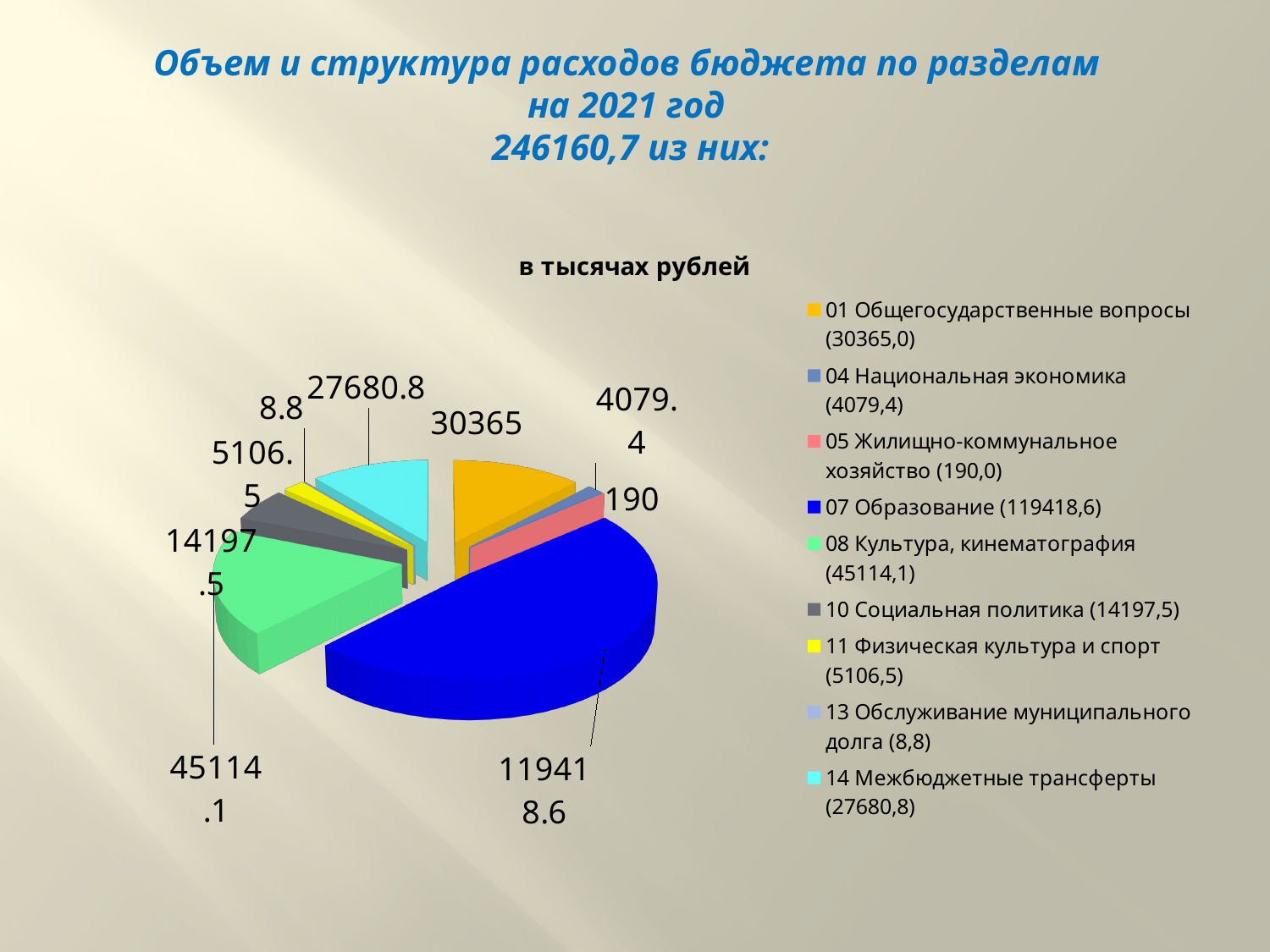
What is the value for 07 Образование? 119418.6 What is the difference between 08 Культура, кинематография and 10 Социальная политика? 30916.6 Which is larger, 01 Общегосударственные вопросы or 14 Межбюджетные трансферты? 01 Общегосударственные вопросы What is the value for 05 Жилищно-коммунальное хозяйство? 190 Which category has the smallest slice? 13 Обслуживание муниципального долга What is the value for 14 Межбюджетные трансферты? 27680.8 Which category has the largest slice? 07 Образование How many categories does the legend list? 9 What kind of chart is shown on the slide? pie chart What is the title of the chart? в тысячах рублей What is the value for 08 Культура, кинематография? 45114.1 What is the difference between 01 Общегосударственные вопросы and 14 Межбюджетные трансферты? 2684.2